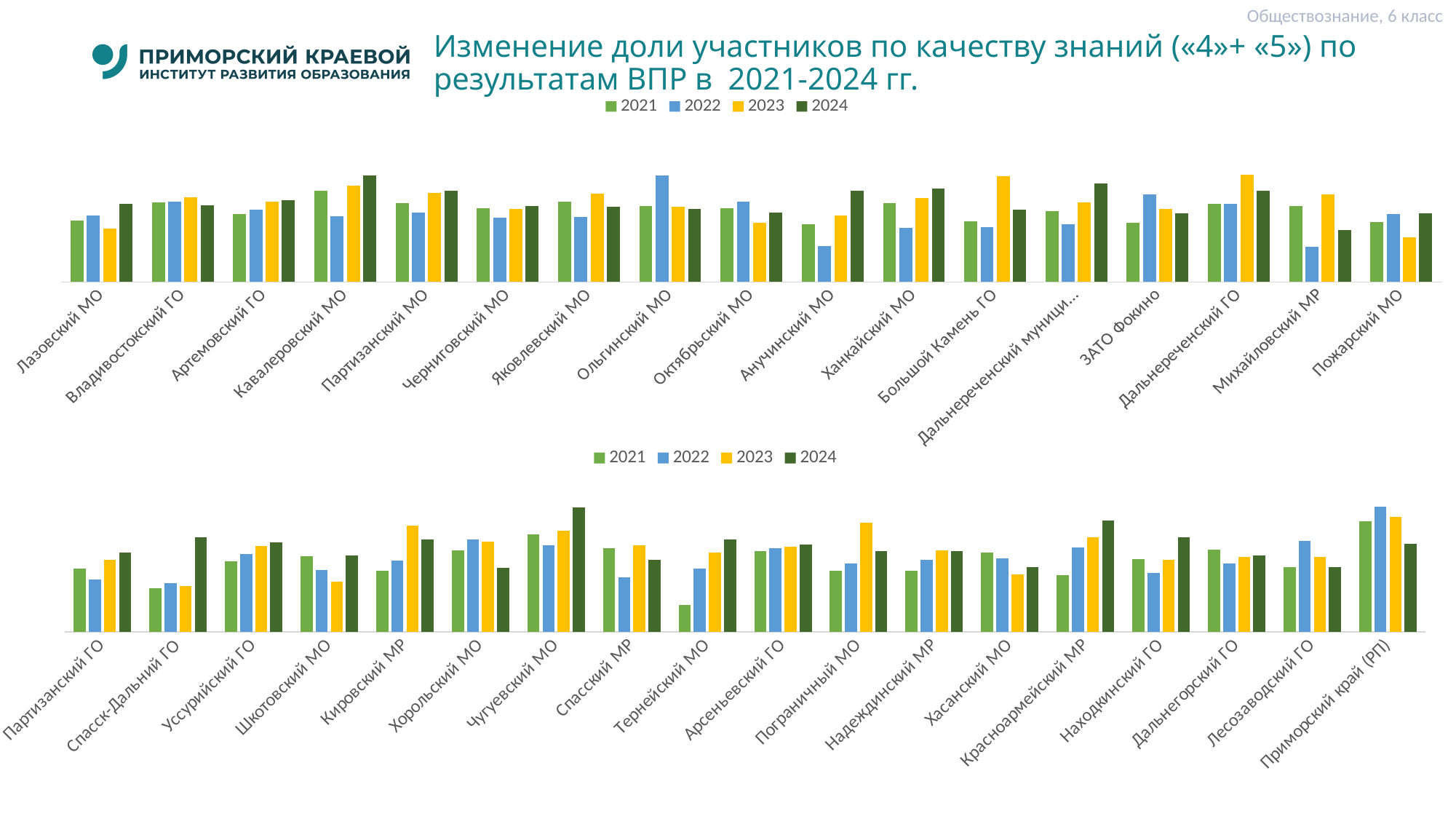
In the top chart, which year has the highest bar for Большой Камень ГО? 2023 How many series does the legend of the top chart list? 4 In the legend of the bottom chart, which year is shown in yellow? 2023 In the bottom chart, which year has the highest bar for Чугуевский МО? 2024 In the bottom chart, do the bars for Красноармейский МР rise or fall from 2021 to 2024? rise How many categories are shown on the x axis of the bottom chart? 18 In the top chart, which year has the lowest bar for Михайловский МР? 2022 In the top chart, which year has the highest bar for Ольгинский МО? 2022 How many categories are shown on the x axis of the top chart? 17 In the top chart, which is larger for 2022: Ольгинский МО or Анучинский МО? Ольгинский МО In the bottom chart, which year has the lowest bar for Тернейский МО? 2021 What kind of chart is the top chart on the slide? bar chart